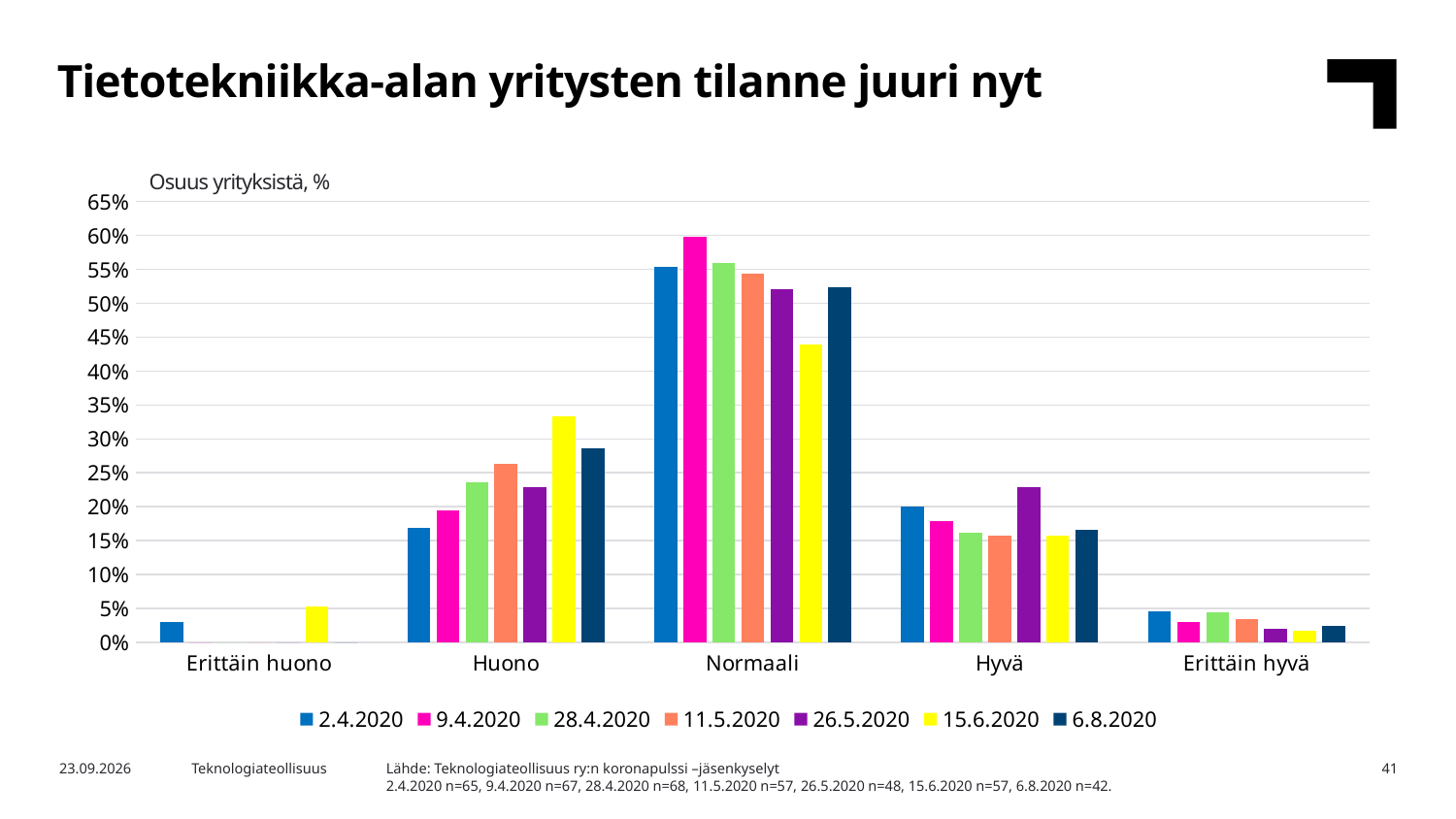
In the Hyvä category, which is larger: the 26.5.2020 bar or the 2.4.2020 bar? 26.5.2020 In the Hyvä category, which series has the highest bar? 26.5.2020 What kind of chart is shown on the slide? bar chart Is the value for Normaali in the 15.6.2020 series greater or less than 50%? less How many series does the legend list? 7 How many categories are shown on the x axis? 5 In the Normaali category, which series has the highest bar? 9.4.2020 What is the label shown above the vertical axis of the chart? Osuus yrityksistä, % Which category has the highest value for the 9.4.2020 series? Normaali Is the value for Huono in the 15.6.2020 series greater or less than 30%? greater Is the value for Normaali in the 9.4.2020 series greater or less than 55%? greater